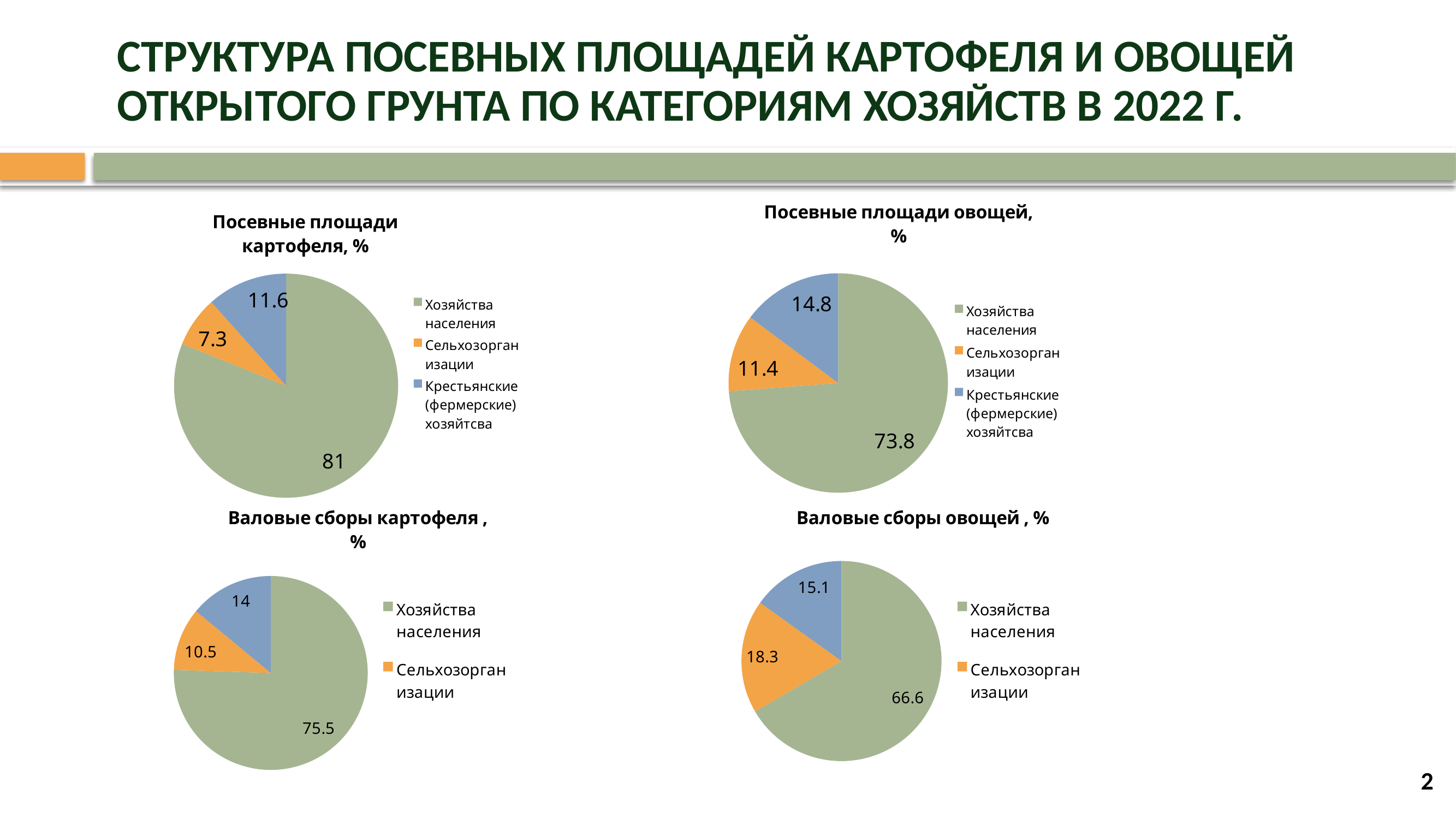
In the chart titled "Валовые сборы картофеля, %", which is larger: the value for Хозяйства населения or the value for Сельхозорганизации? Хозяйства населения In the chart titled "Посевные площади картофеля, %", what is the value for Хозяйства населения? 81 In the chart titled "Посевные площади овощей, %", what is the value for Крестьянские (фермерские) хозяйства? 14.8 How many entries does the legend of the chart titled "Посевные площади овощей, %" list? 3 In the chart titled "Валовые сборы картофеля, %", what is the value for Хозяйства населения? 75.5 How many slices does the chart titled "Посевные площади картофеля, %" have? 3 In the chart titled "Валовые сборы овощей, %", what is the value for Сельхозорганизации? 18.3 In the chart titled "Посевные площади овощей, %", what is the difference between the values for Хозяйства населения and Сельхозорганизации? 62.4 In the chart titled "Посевные площади картофеля, %", which category has the smallest share? Сельхозорганизации What type of chart is used for "Валовые сборы овощей, %"? Pie chart In the chart titled "Посевные площади овощей, %", which category has the largest share? Хозяйства населения In the chart titled "Посевные площади картофеля, %", what is the value for Сельхозорганизации? 7.3